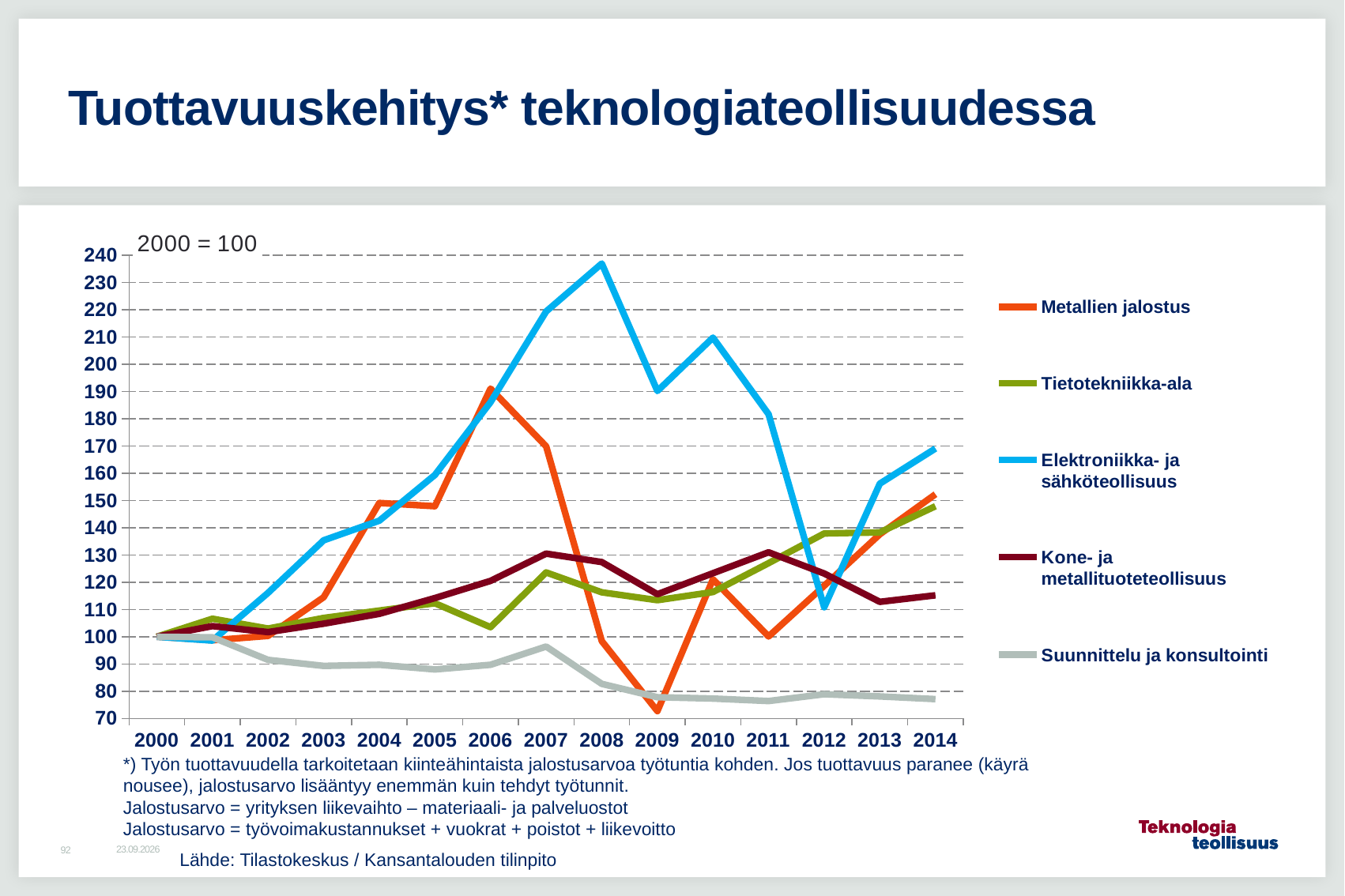
Which series has the highest value in 2008? Elektroniikka- ja sähköteollisuus Is the value for Elektroniikka- ja sähköteollisuus in 2008 greater or less than 230? greater What base-year note is printed above the chart's y axis? 2000 = 100 Is the value for Metallien jalostus in 2009 greater or less than 80? less Which series has the lowest value in 2014? Suunnittelu ja konsultointi In 2011, which is larger: Kone- ja metallituoteteollisuus or Metallien jalostus? Kone- ja metallituoteteollisuus How many years are shown on the x axis? 15 In 2012, which is larger: Tietotekniikka-ala or Elektroniikka- ja sähköteollisuus? Tietotekniikka-ala How many series does the legend list? 5 Does the Suunnittelu ja konsultointi line rise or fall from 2000 to 2014? fall What kind of chart is shown on the slide? line chart Is the value for Elektroniikka- ja sähköteollisuus in 2012 greater or less than 120? less